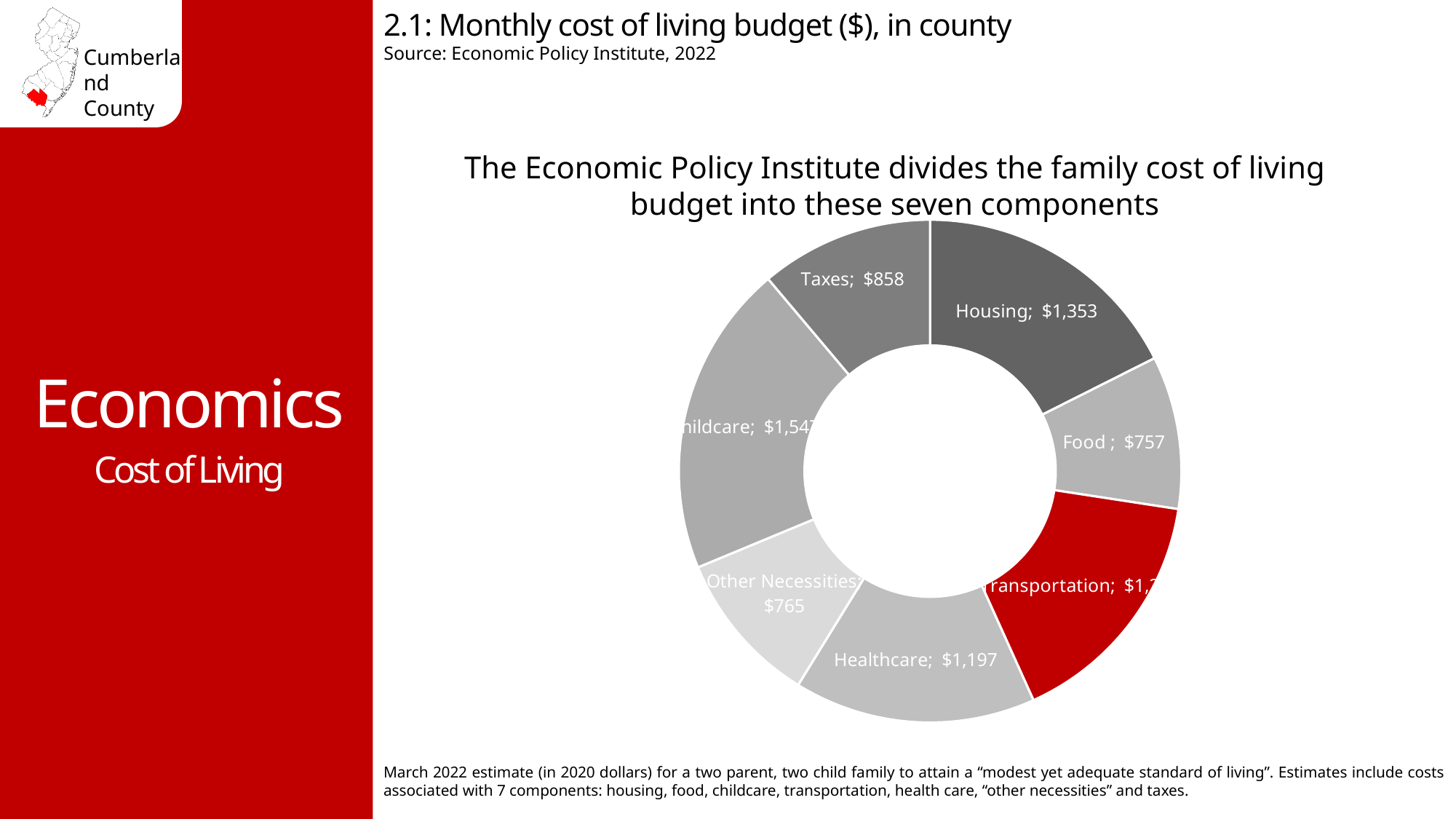
What is the monthly cost for Healthcare? $1,197 Which is larger, the value for Taxes or the value for Food? Taxes What is the monthly cost for Housing in the donut chart? $1,353 Which component has the largest slice in the chart? Childcare Which component is shown in red in the chart? Transportation What is the difference between the Housing and Healthcare values? $156 What is the monthly cost for Food? $757 What kind of chart is shown on the slide? Pie (donut) chart What is the monthly cost for Taxes? $858 What is the monthly cost for Other Necessities? $765 How many components are shown in the chart? 7 What is the difference between the Housing and Taxes values? $495